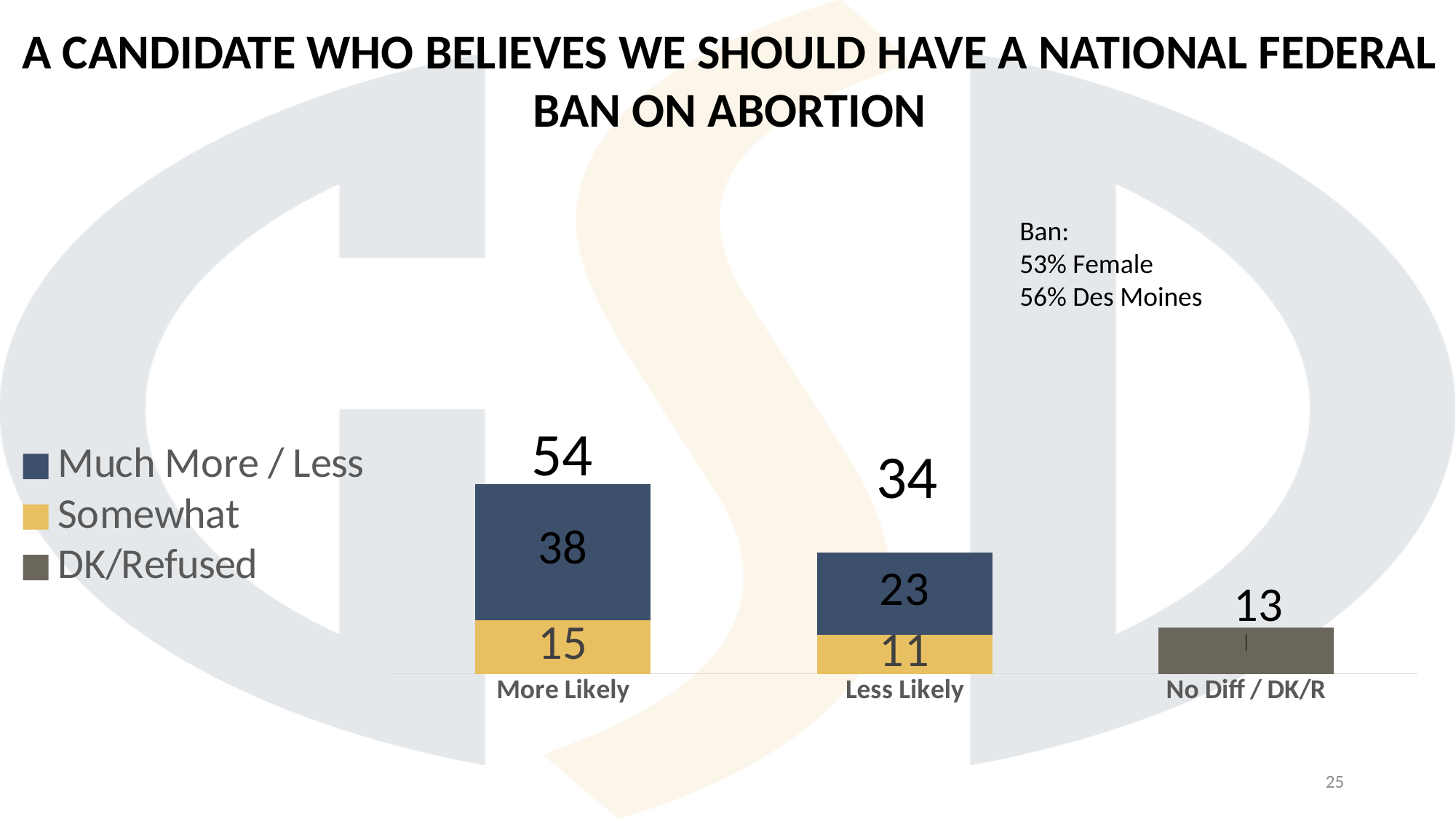
What is the value of the Somewhat segment for Less Likely? 11 What is the total labelled above the Less Likely bar? 34 Which category has the lowest total? No Diff / DK/R What is the value of the Much More / Less segment for More Likely? 38 Which category has the highest total? More Likely What is the total labelled above the More Likely bar? 54 How many series does the legend list? 3 What is the difference between the Somewhat values for More Likely and Less Likely? 4 Which is larger: the Somewhat value for More Likely or the Somewhat value for Less Likely? More Likely What is the difference between the Much More / Less values for More Likely and Less Likely? 15 How many categories are shown on the x axis? 3 What is the value shown for No Diff / DK/R? 13